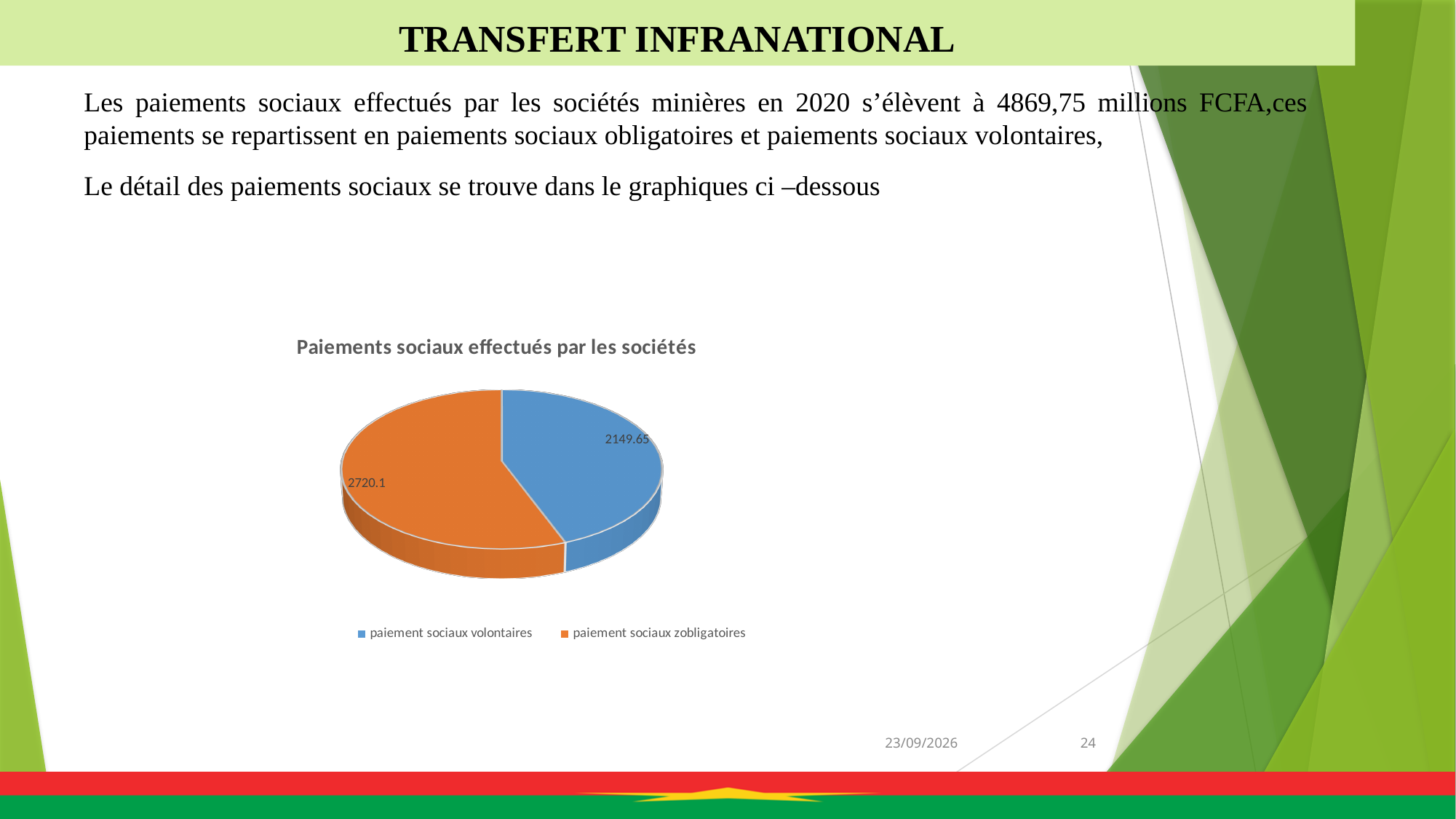
Which category has the largest slice of the pie? paiement sociaux zobligatoires What is the difference between the value for paiement sociaux zobligatoires and the value for paiement sociaux volontaires? 570.45 Which category has the smallest slice of the pie? paiement sociaux volontaires What is the title of the chart? Paiements sociaux effectués par les sociétés What is the total of the two values shown in the pie chart? 4869.75 What is the value for paiement sociaux zobligatoires? 2720.1 Which colour represents paiement sociaux volontaires in the chart? Blue What is the value for paiement sociaux volontaires? 2149.65 How many slices does the pie chart have? 2 What type of chart is shown on the slide? Pie chart Which is larger: paiement sociaux volontaires or paiement sociaux zobligatoires? paiement sociaux zobligatoires What share of the pie does paiement sociaux zobligatoires represent? 55.86%